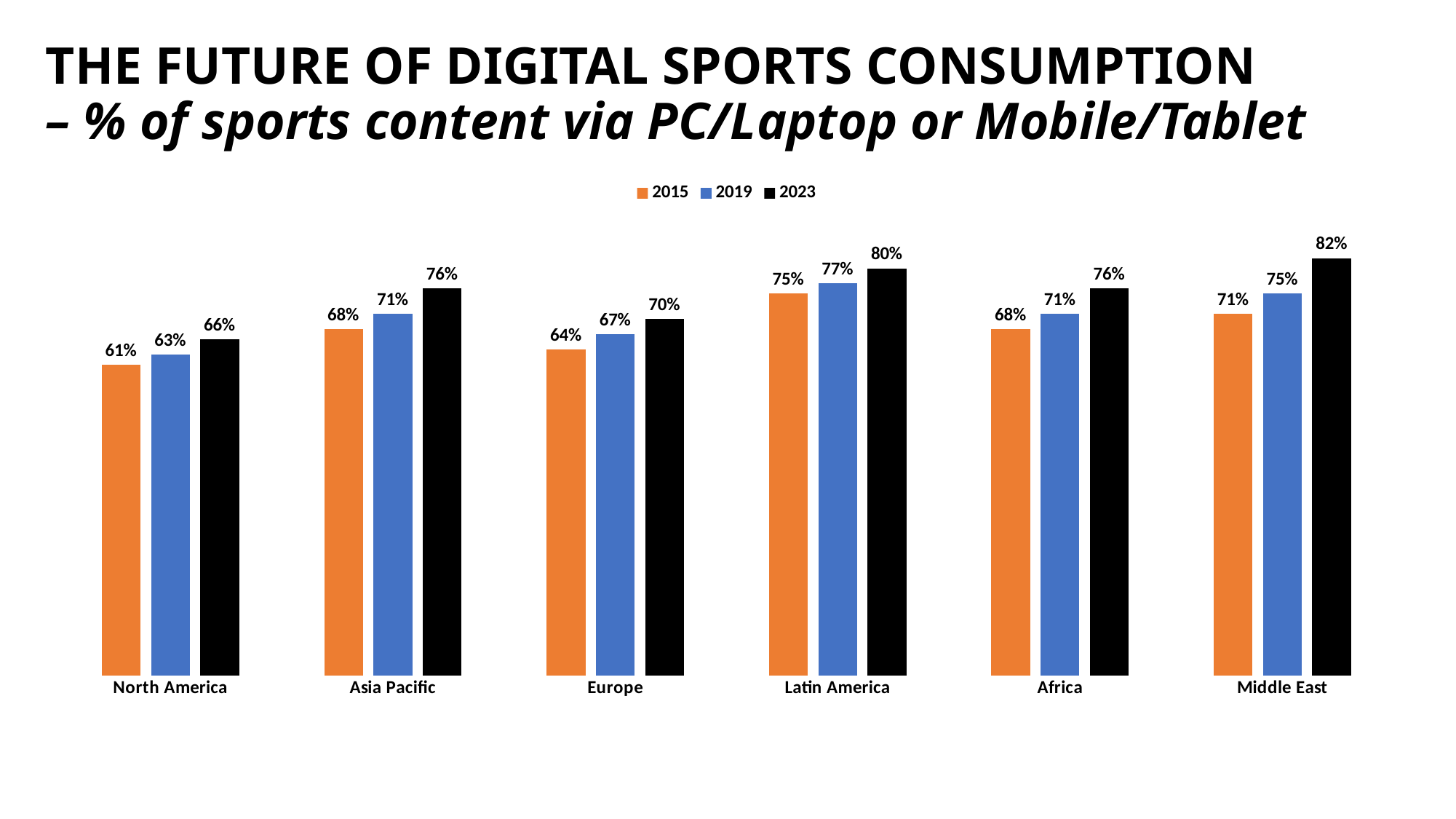
What is the difference between the 2023 and 2015 values for Asia Pacific? 8% How many series does the legend list? 3 What kind of chart is shown on the slide? Bar chart Which is larger, the 2019 value for Africa or the 2019 value for Europe? Africa What is the 2015 value for Europe? 64% How many regions are shown on the x axis? 6 What is the 2023 value for Middle East? 82% Which region has the highest 2023 value? Middle East Which colour represents the 2019 series in the legend? Blue What is the 2019 value for Latin America? 77% Which region has the lowest 2015 value? North America For North America, do the values rise or fall from 2015 to 2023? Rise